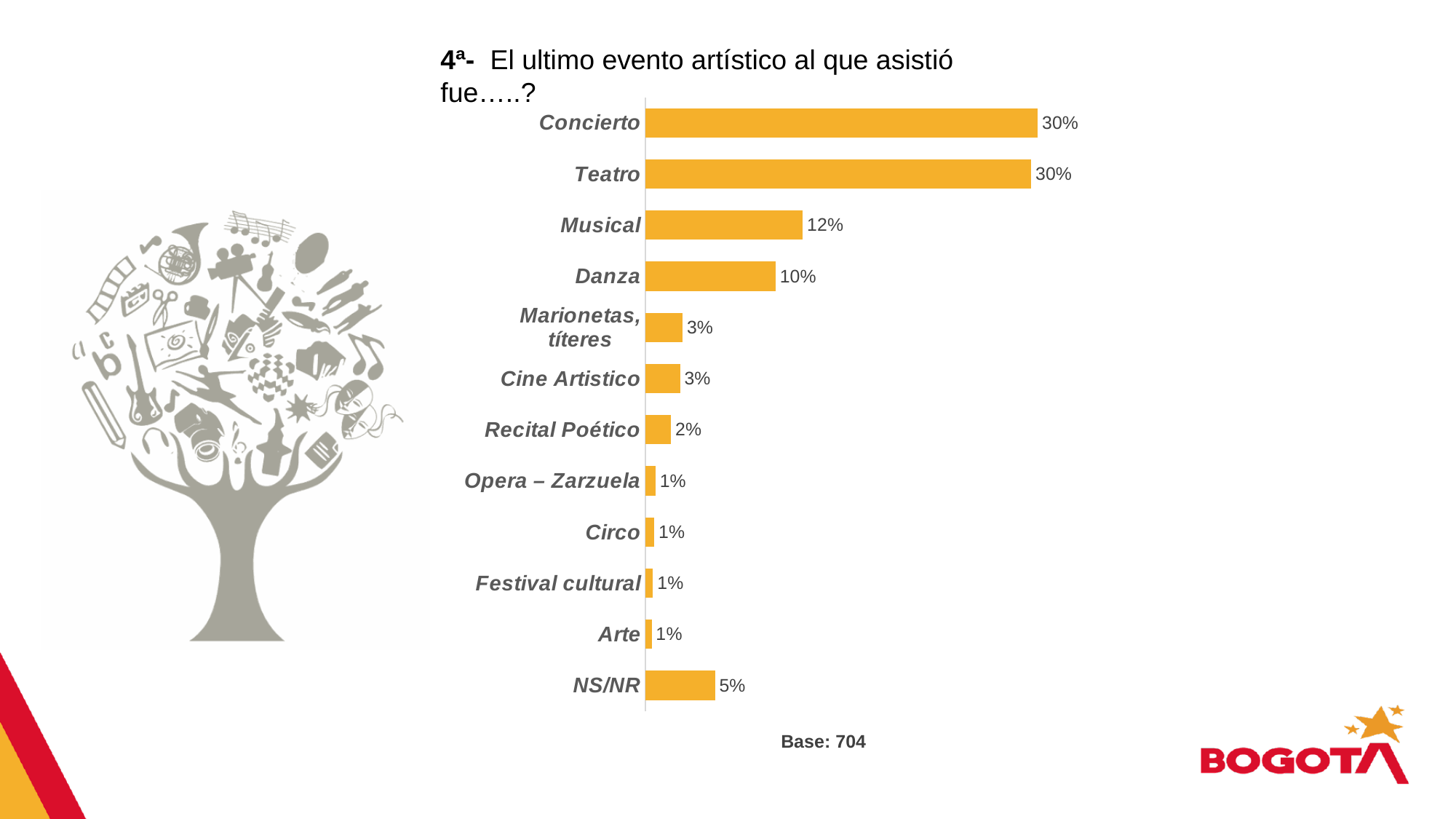
What is the value for Musical? 12% How many categories are shown in the chart? 12 Which has a larger value, Musical or Danza? Musical What is the difference between the values for Danza and NS/NR? 5% What percentage is shown for Concierto? 30% What percentage is shown for Danza? 10% What is the value for NS/NR? 5% What is the value for Marionetas, títeres? 3% What base (number of respondents) is stated below the chart? 704 What is the difference between the values for Concierto and Musical? 18% What kind of chart is shown on the slide? Bar chart What percentage is shown for Recital Poético? 2%